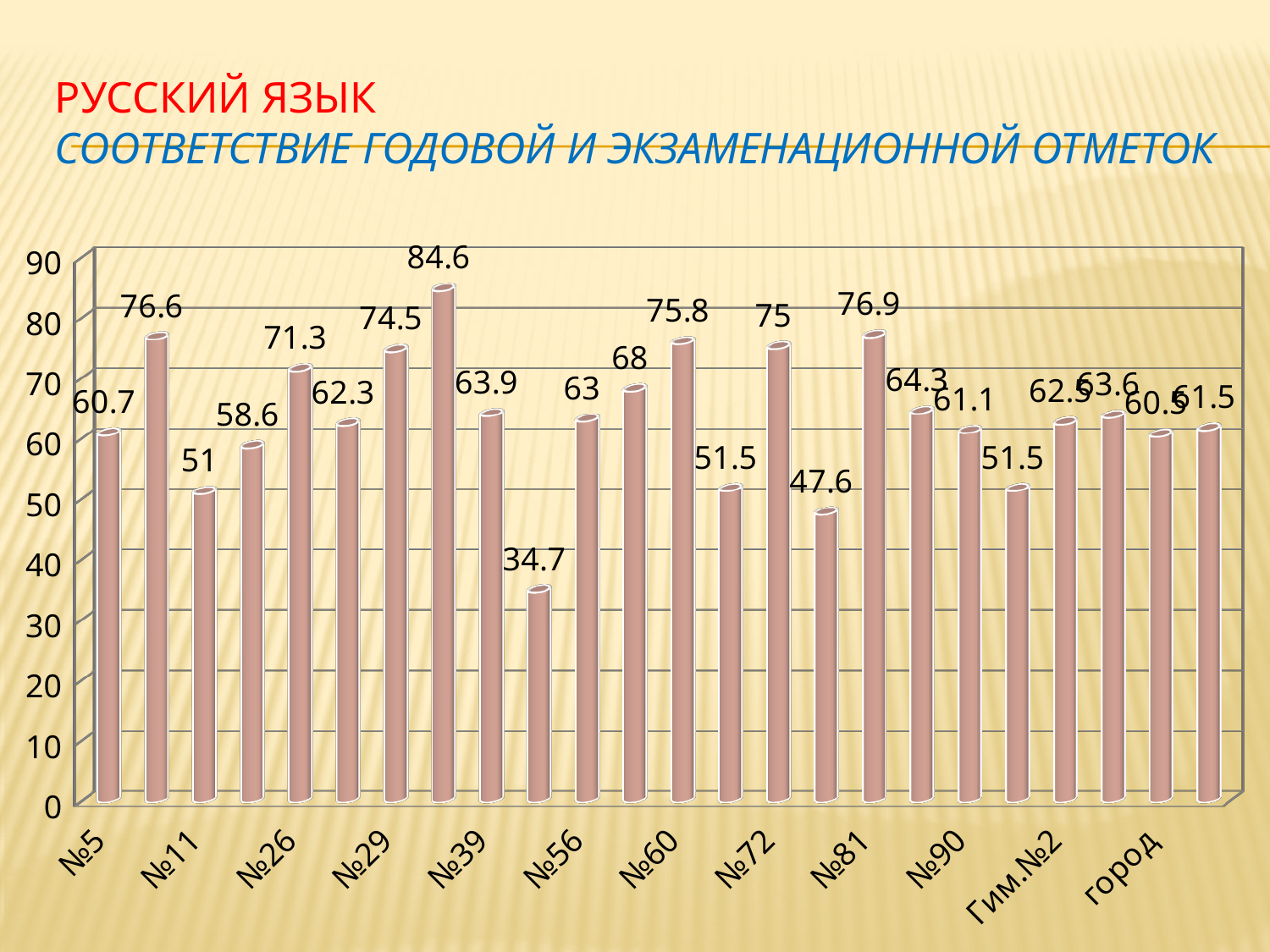
Which is larger: the bar labelled 76.6 or the bar labelled 84.6? 84.6 What type of chart is shown on the slide? bar chart What is the maximum value shown on the vertical axis? 90 Is the lowest bar in the chart greater or less than 40? less What is the difference between the highest value (84.6) and the lowest value (34.7) in the chart? 49.9 What is the subtitle of the chart written in blue italics? СООТВЕТСТВИЕ ГОДОВОЙ И ЭКЗАМЕНАЦИОННОЙ ОТМЕТОК How many bars are plotted in the chart? 24 How many bars in the chart have a value above 80? 1 What is the highest value shown in the chart? 84.6 Is the value of the bar for №5 greater or less than 60? greater What is the value of the bar for №5? 60.7 What is the lowest value shown in the chart? 34.7